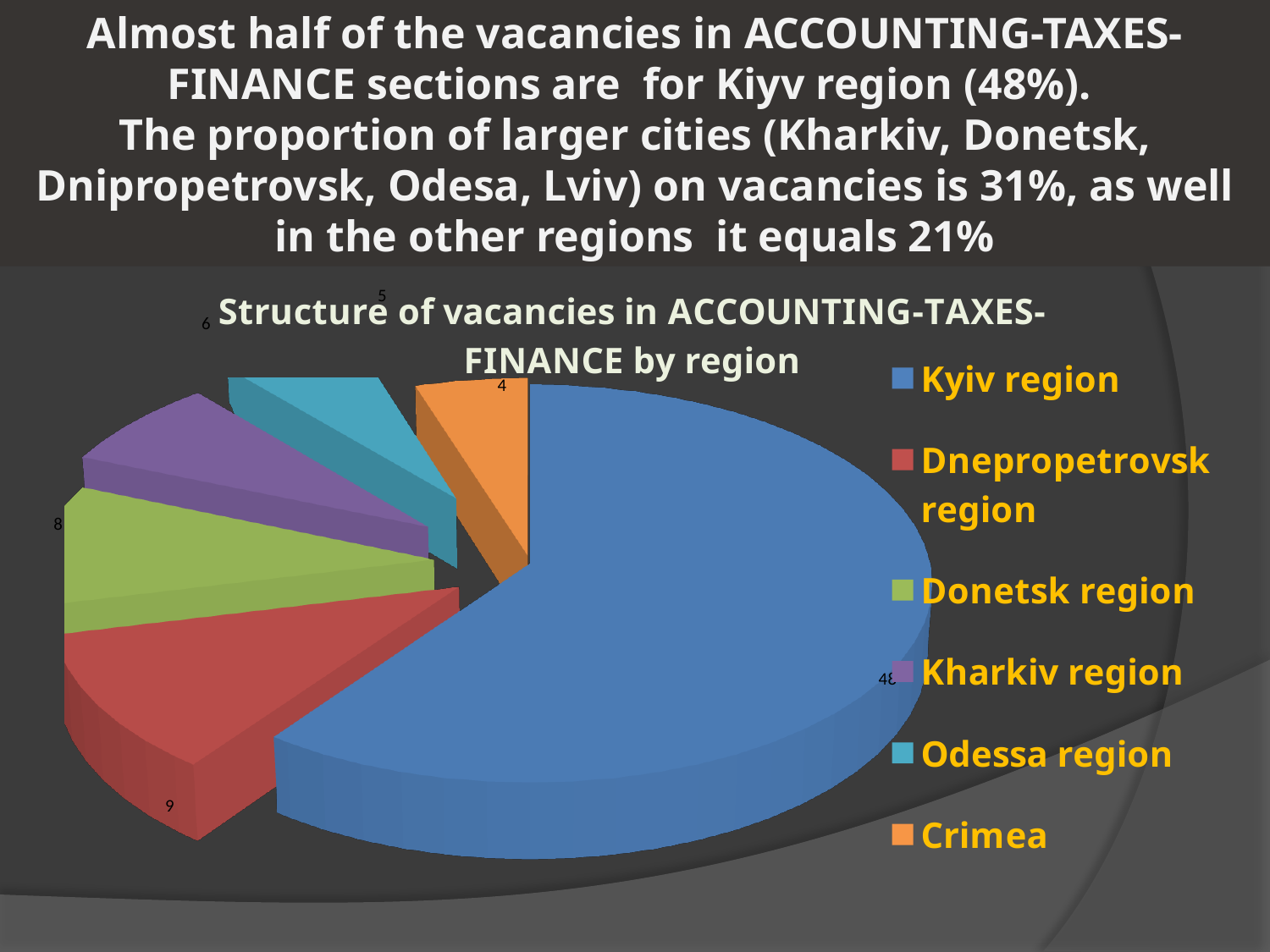
Which region has the largest slice of the pie chart? Kyiv region What is the data label value for Kharkiv region? 6 What is the data label value for Crimea? 4 What is the data label value for Dnepropetrovsk region? 9 Which region has the smallest slice of the pie chart? Crimea What is the data label value for Odessa region? 5 What kind of chart is shown on the slide? pie chart How many regions (slices) does the pie chart show? 6 What colour is the slice for Kyiv region? blue Which is larger, the value for Donetsk region or the value for Kharkiv region? Donetsk region What is the data label value for Donetsk region? 8 What is the difference between the values for Dnepropetrovsk region and Crimea? 5